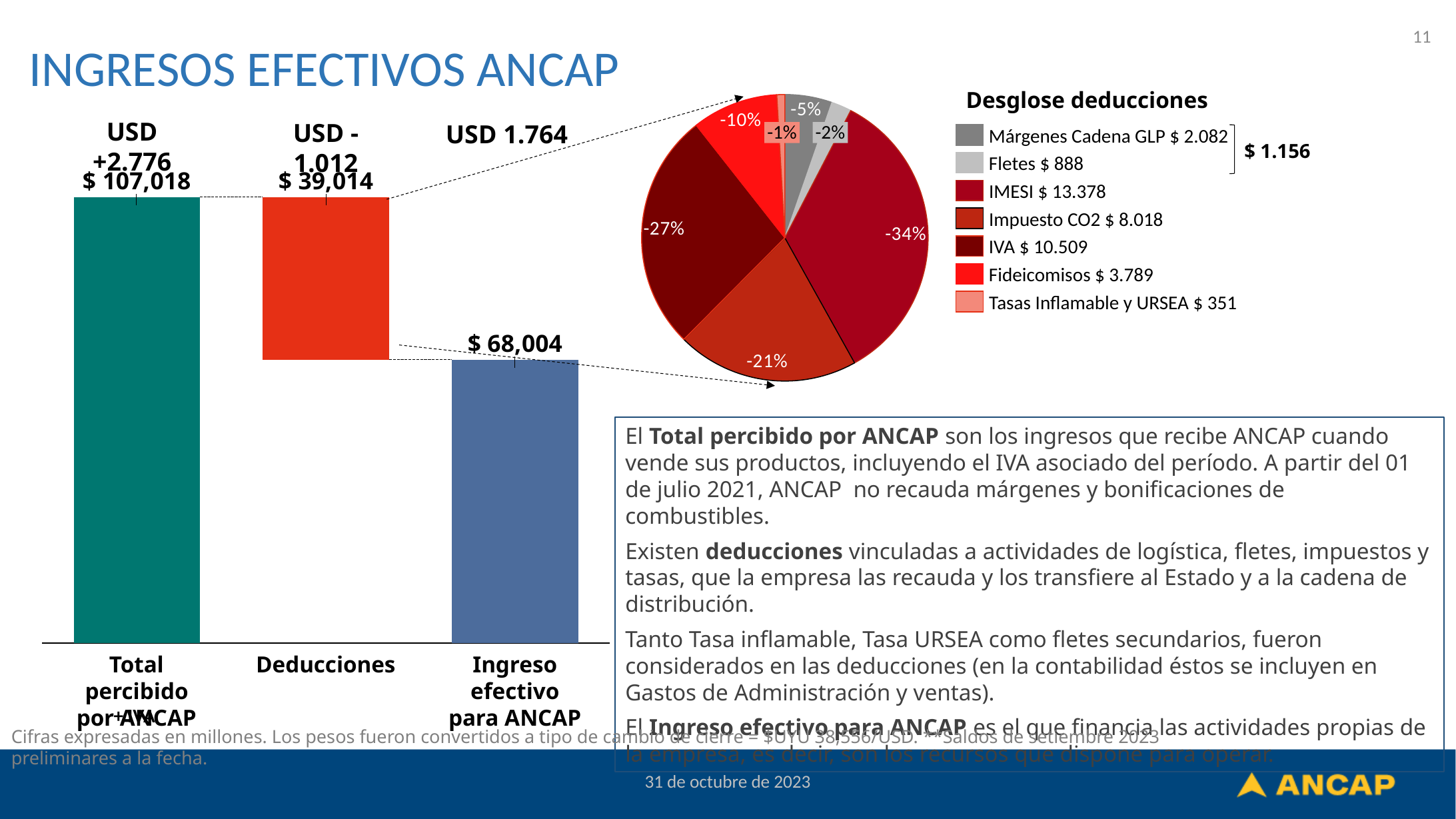
In the Desglose deducciones pie chart, what share does IMESI represent? -34% In the bar chart on the left, what is the value for Total percibido por ANCAP? $ 107,018 In the Desglose deducciones pie chart, which category has the smallest slice? Tasas Inflamable y URSEA In the bar chart on the left, what is the difference between Total percibido por ANCAP and Ingreso efectivo para ANCAP? $ 39,014 What kind of chart is the Desglose deducciones chart? Pie chart How many entries does the legend of the Desglose deducciones pie chart list? 7 In the bar chart on the left, what is the value for Ingreso efectivo para ANCAP? $ 68,004 In the bar chart on the left, which category has the lowest value? Deducciones In the bar chart on the left, what is the value for Deducciones? $ 39,014 In the bar chart on the left, which category has the highest value? Total percibido por ANCAP In the bar chart on the left, how many bars are plotted? 3 In the Desglose deducciones pie chart, what is the value for Impuesto CO2? $ 8.018